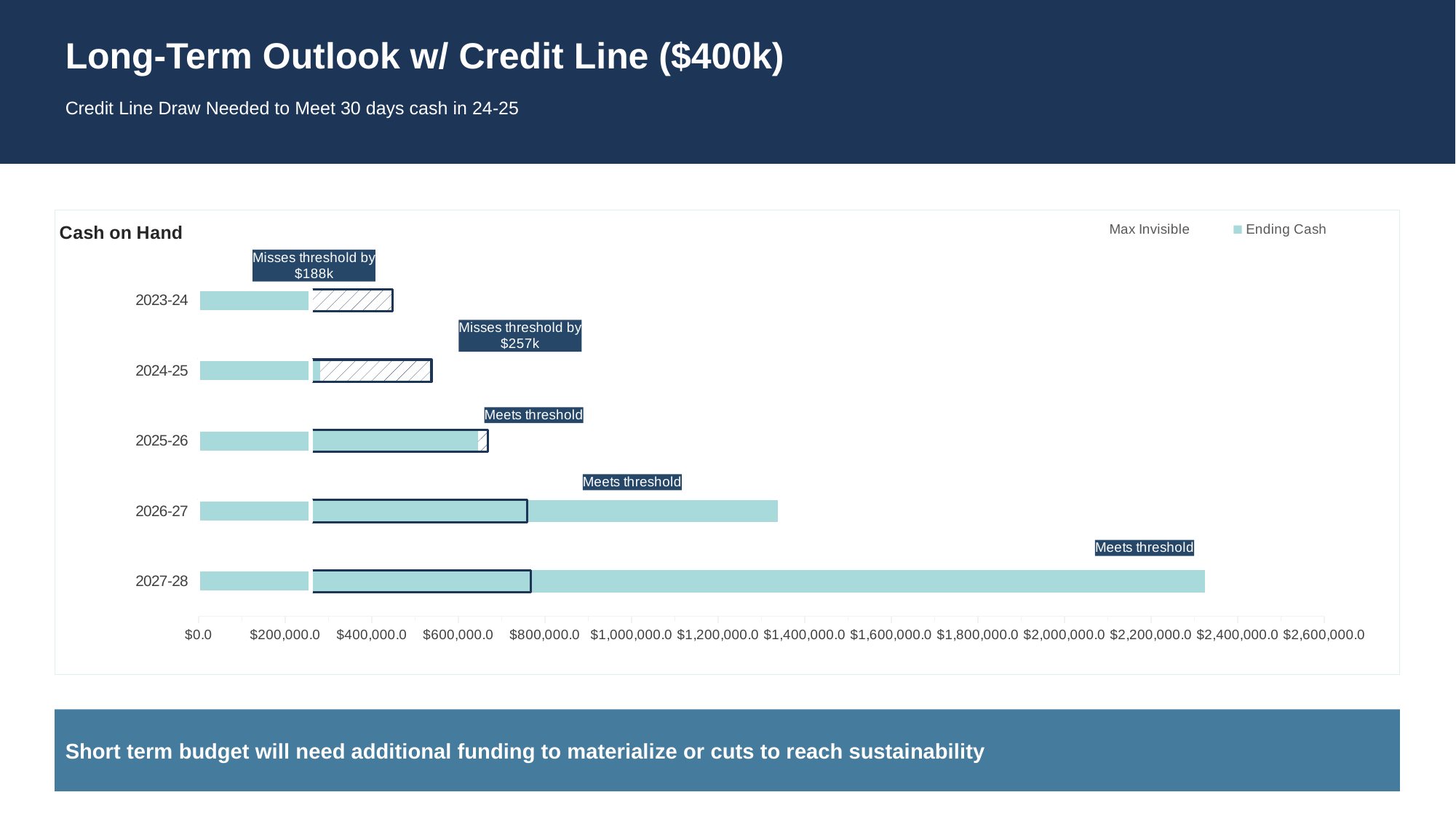
By how much does 2024-25 miss the threshold, according to the label on the chart? $257k Do the Ending Cash values rise or fall from 2023-24 to 2027-28? rise Which has the larger Ending Cash value, 2025-26 or 2026-27? 2026-27 Is the Ending Cash value for 2025-26 greater or less than $800,000.0? less How many fiscal years are shown on the Cash on Hand chart? 5 Is the Ending Cash value for 2026-27 greater or less than $1,200,000.0? greater How many series does the legend of the Cash on Hand chart list? 2 Is the Ending Cash value for 2027-28 greater or less than $2,000,000.0? greater Which fiscal year has the highest Ending Cash value? 2027-28 What kind of chart is shown on the slide? bar chart What is the title of the chart on the slide? Cash on Hand